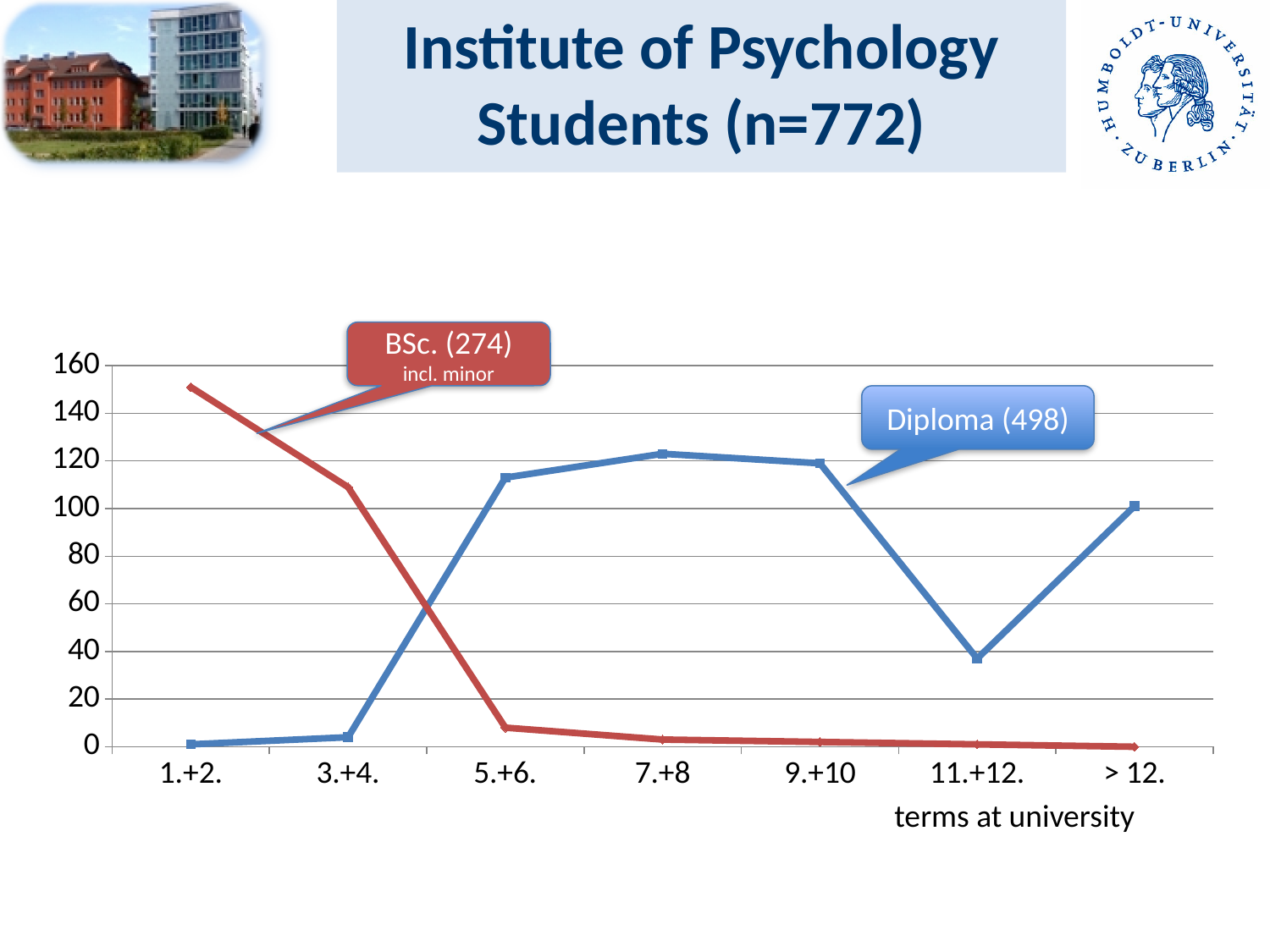
What kind of chart is shown on the slide? line chart Is the BSc. value for 5.+6. terms greater or less than 20? less Which series has the larger value at 3.+4. terms, BSc. or Diploma? BSc. What is the label of the x axis? terms at university Is the Diploma value for 11.+12. terms greater or less than 60? less How many categories are shown along the x axis of the chart? 7 Which series does the red line represent? BSc. (274) Is the BSc. value for 1.+2. terms greater or less than 140? greater At which term category does the BSc. line reach its highest value? 1.+2. How many data series are plotted in the chart? 2 At which term category does the Diploma line reach its highest value? 7.+8